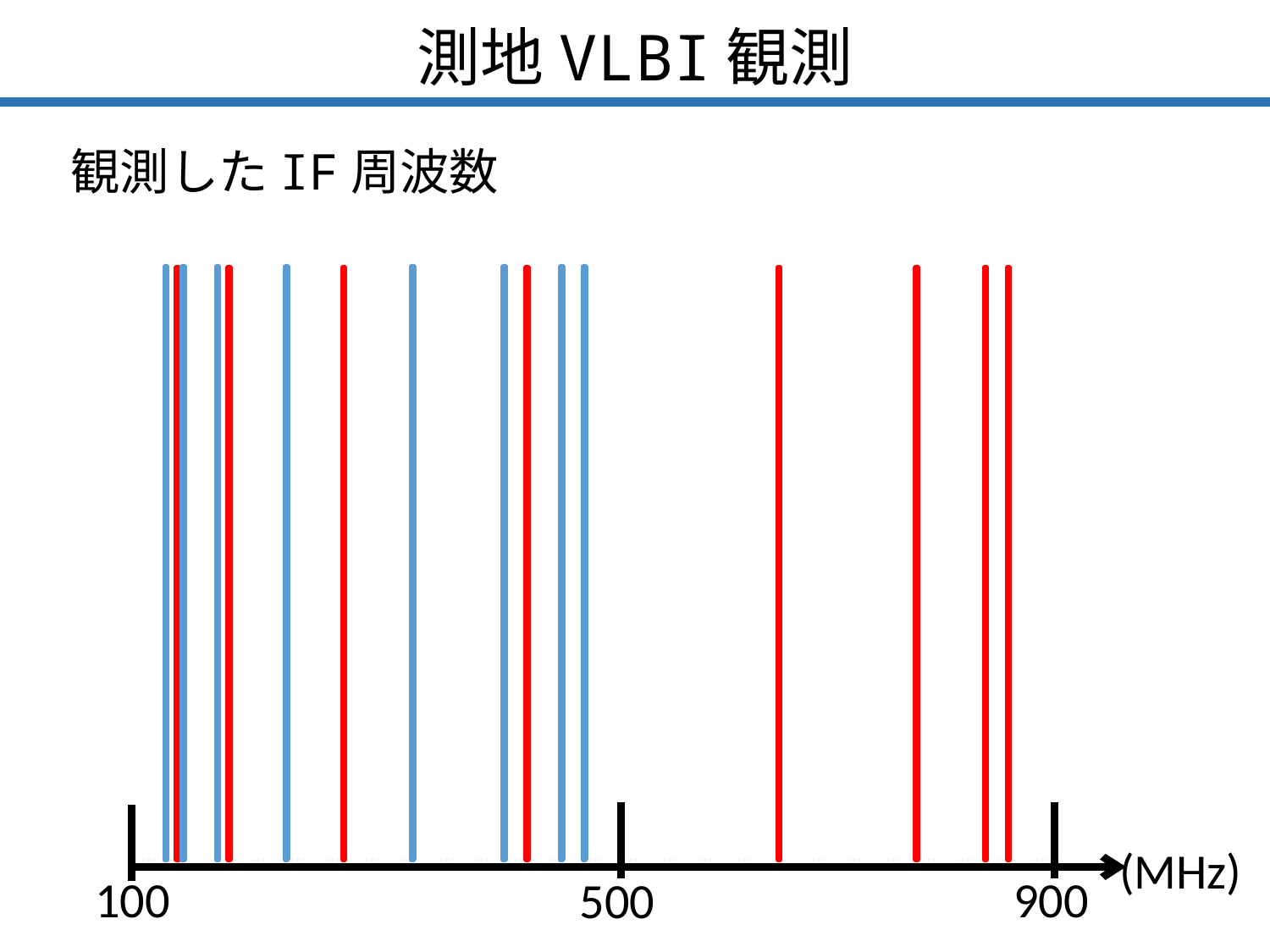
What are the three tick values labelled on the horizontal axis? 100, 500, 900 Is the frequency of the rightmost blue line greater or less than 500 MHz? less How many red vertical lines are plotted on the chart? 8 Is the frequency of the leftmost blue line greater or less than 500 MHz? less Is the frequency of the rightmost red line greater or less than 900 MHz? less How many vertical lines are plotted on the chart in total? 16 What unit is shown on the horizontal axis of the chart? MHz How many blue vertical lines are plotted on the chart? 8 Which colour of line reaches the highest frequency on the chart, red or blue? red